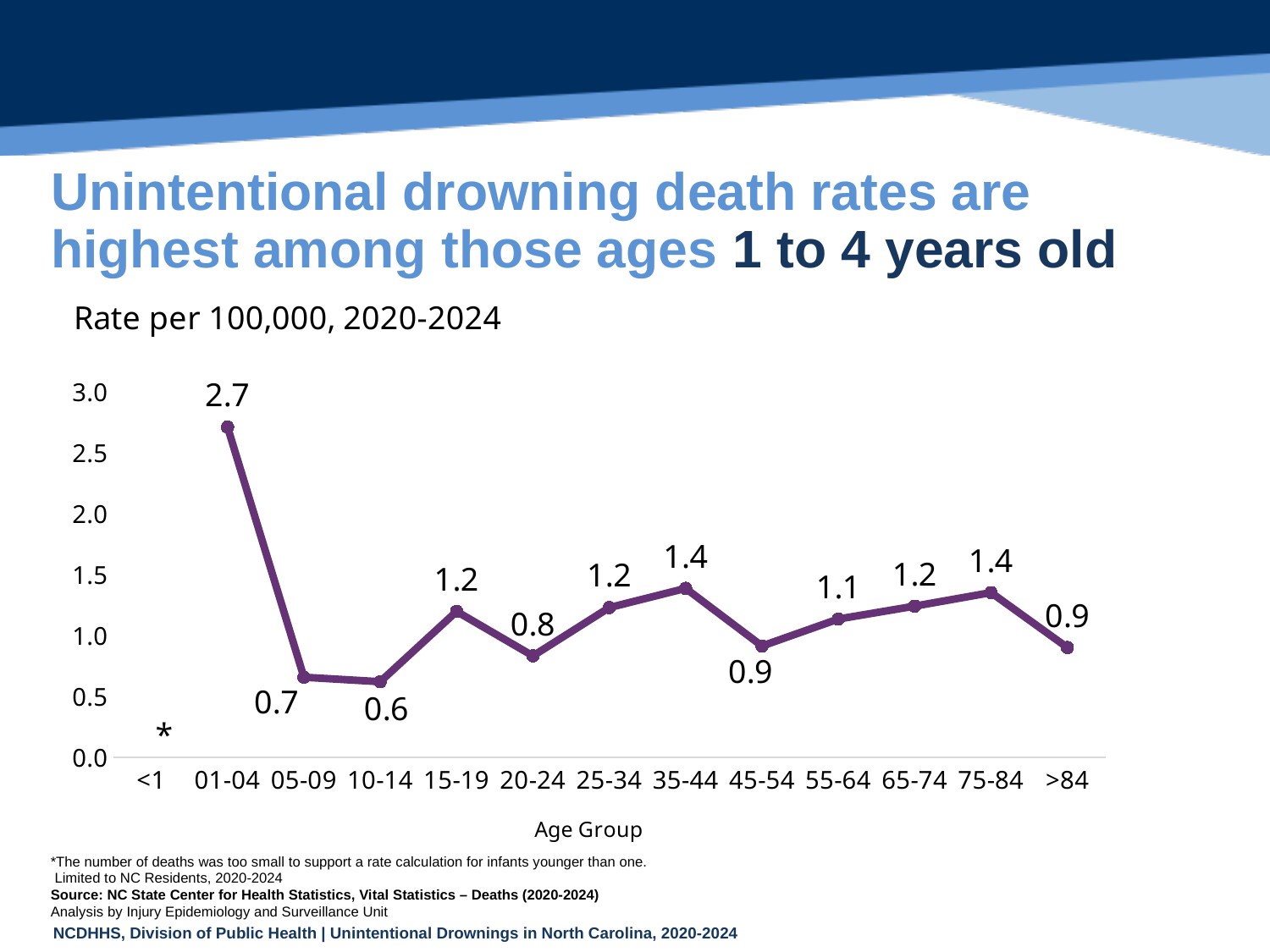
Which age group has the highest drowning death rate? 01-04 What is the rate per 100,000 for the 10-14 age group? 0.6 What type of chart is shown on the slide? line chart How many age group categories are labeled on the x axis? 13 What is the rate per 100,000 for the >84 age group? 0.9 Which age group has the lowest plotted drowning death rate? 10-14 Is the value for the 01-04 age group greater or less than 2.0? greater What is the difference between the rate for the 01-04 age group and the rate for the 05-09 age group? 2.0 What is the label of the x axis? Age Group Which has a higher rate, the 20-24 age group or the 25-34 age group? 25-34 What is the unintentional drowning death rate per 100,000 for the 01-04 age group? 2.7 What is the rate per 100,000 for the 35-44 age group? 1.4